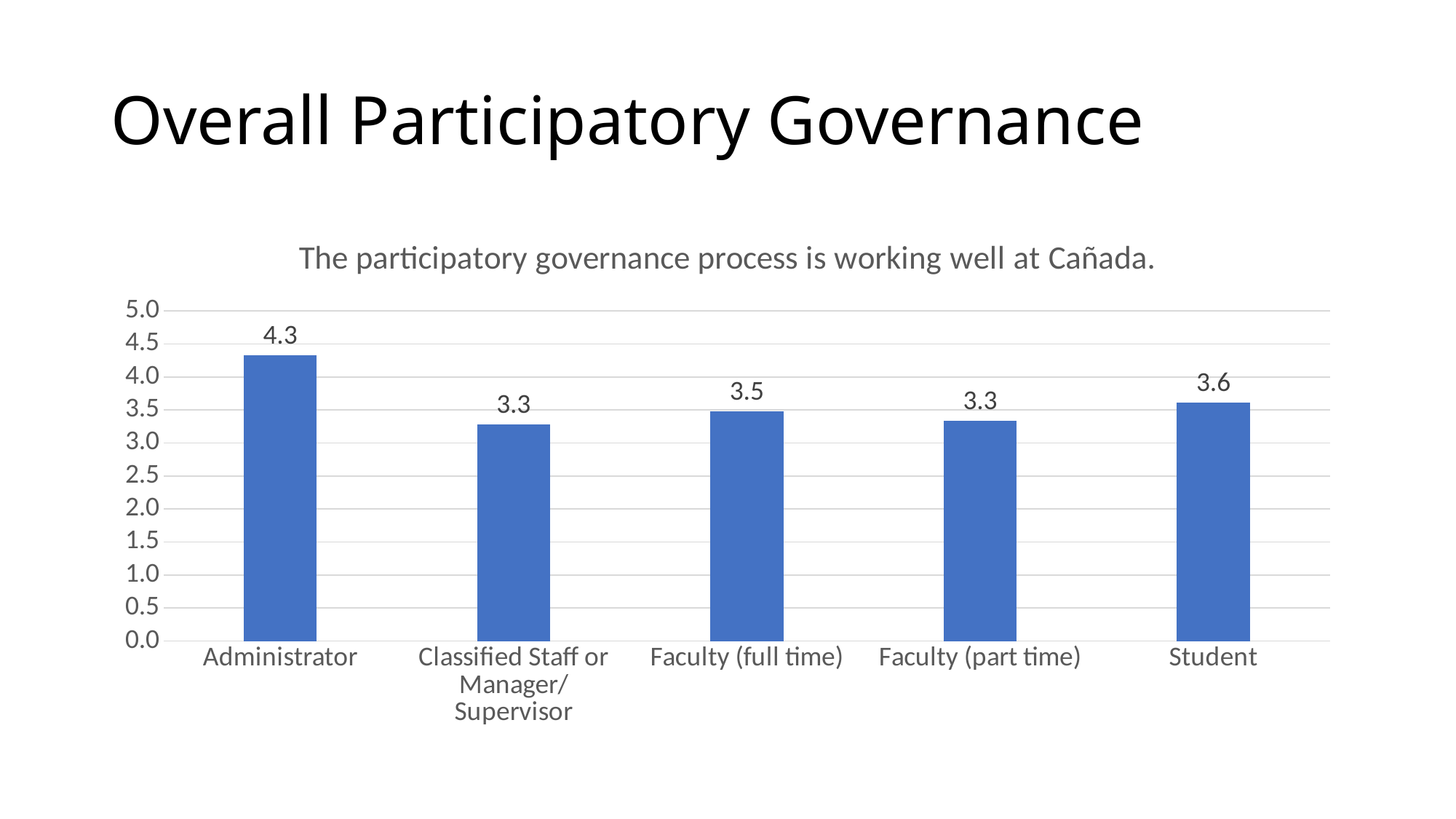
What is the title of the chart? The participatory governance process is working well at Cañada. What is the value for Administrator? 4.3 What is the value for Faculty (full time)? 3.5 What is the difference between the values for Administrator and Student? 0.7 Which is larger, the value for Student or the value for Faculty (full time)? Student How many categories are shown on the x axis? 5 Which category has the highest value? Administrator What kind of chart is shown on the slide? bar chart What is the difference between the values for Faculty (full time) and Faculty (part time)? 0.2 Is the value for Administrator greater or less than 4.0? greater What is the value for Student? 3.6 What is the value for Classified Staff or Manager/Supervisor? 3.3